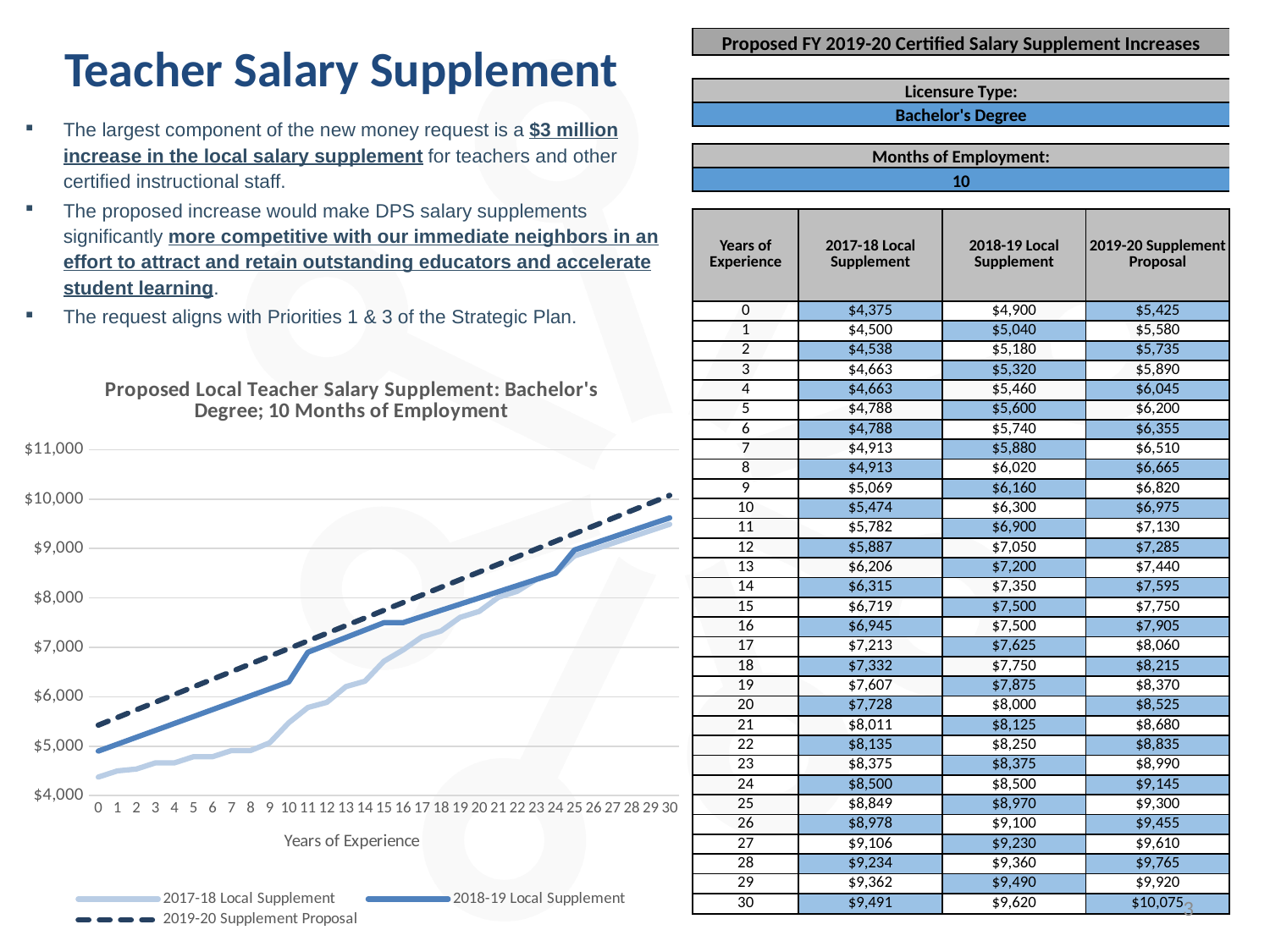
In the chart, is the 2017-18 Local Supplement value at 0 years of experience greater or less than $5,000? less How many series does the chart's legend list? 3 In the chart, is the 2017-18 Local Supplement value at 10 years of experience greater or less than $6,000? less At 0 years of experience, which series has the higher value in the chart: 2019-20 Supplement Proposal or 2017-18 Local Supplement? 2019-20 Supplement Proposal How many years of experience values are plotted along the x axis of the chart? 31 In the chart, is the 2019-20 Supplement Proposal value at 20 years of experience greater or less than $8,000? greater Do the values in the chart rise or fall as years of experience increase? rise What kind of chart is shown on the slide? line chart What is the title of the chart? Proposed Local Teacher Salary Supplement: Bachelor's Degree; 10 Months of Employment Which series in the chart is drawn with a dashed line? 2019-20 Supplement Proposal